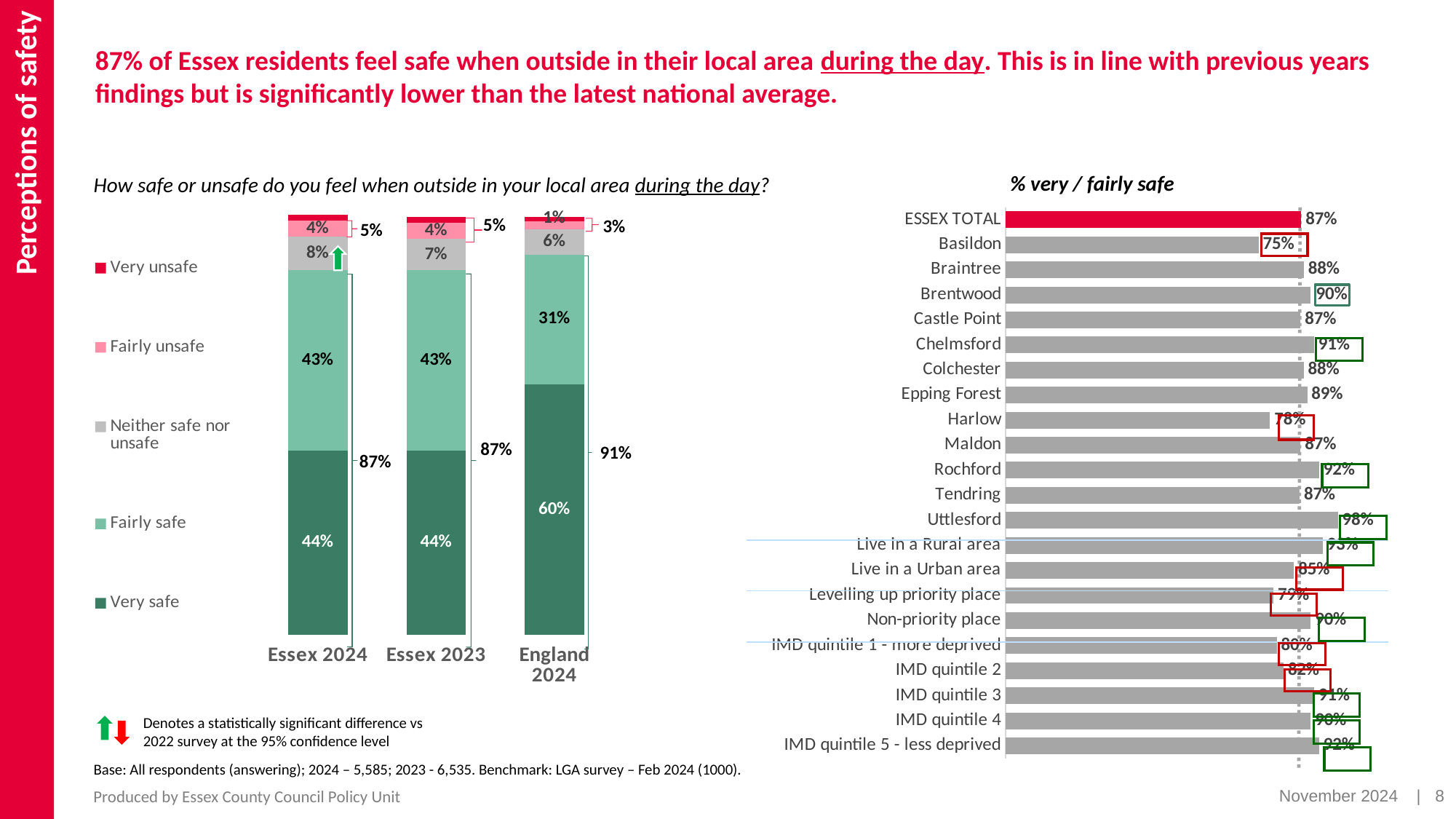
In the left stacked bar chart, which bar has the highest 'Very safe' value? England 2024 How many series does the legend of the left stacked bar chart list? 5 What kind of chart is the left chart on the slide? Stacked bar chart In the '% very / fairly safe' chart, what is the value for Basildon? 75% In the left stacked bar chart, what percentage of England 2024 respondents said they feel very safe? 60% In the left stacked bar chart, what percentage of Essex 2023 respondents said they feel neither safe nor unsafe? 7% In the '% very / fairly safe' chart, what is the value for ESSEX TOTAL? 87% In the '% very / fairly safe' chart, which category has the lowest value? Basildon How many categories are shown in the '% very / fairly safe' chart? 22 In the left stacked bar chart, what percentage of Essex 2024 respondents said they feel fairly safe? 43% In the '% very / fairly safe' chart, which is higher, Chelmsford or Harlow? Chelmsford In the left stacked bar chart, what is the difference between the 'Very safe' values for England 2024 and Essex 2024? 16 percentage points